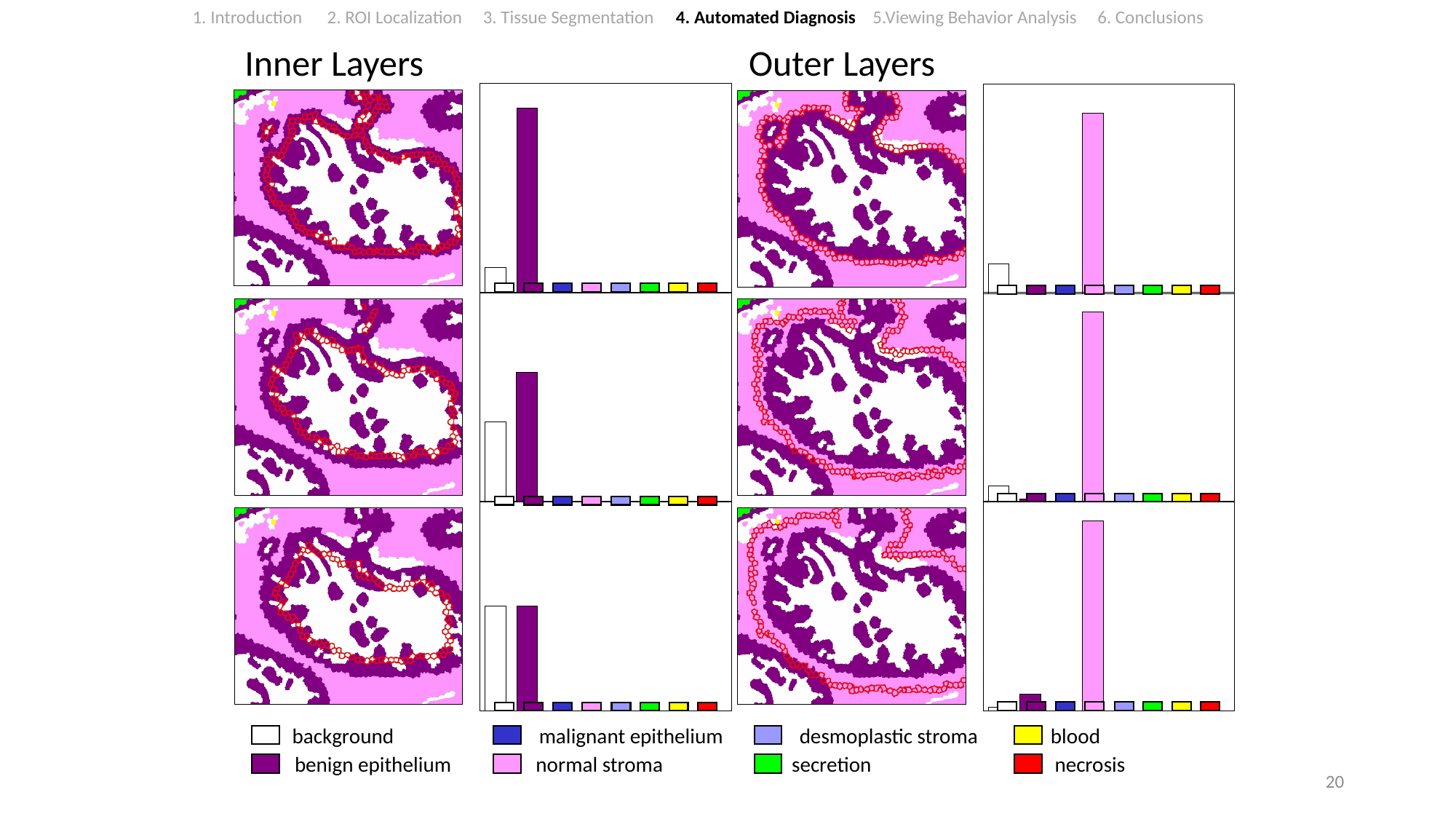
How many bar charts are shown on the slide in total? 6 In the middle chart under the Outer Layers heading, which bar is taller: normal stroma or background? normal stroma How many bars does the top chart under the Inner Layers heading contain? 8 In the middle chart under the Inner Layers heading, which tissue class has the tallest bar? benign epithelium In the bottom chart under the Outer Layers heading, which tissue class has the tallest bar? normal stroma In the top chart under the Inner Layers heading, which tissue class has the tallest bar? benign epithelium According to the legend, what colour represents necrosis in the charts? red What kind of chart is shown in the top chart under the Inner Layers heading? bar chart According to the legend, what colour represents normal stroma in the charts? pink How many tissue classes does the legend at the bottom of the slide list? 8 In the top chart under the Inner Layers heading, which bar is taller: background or benign epithelium? benign epithelium